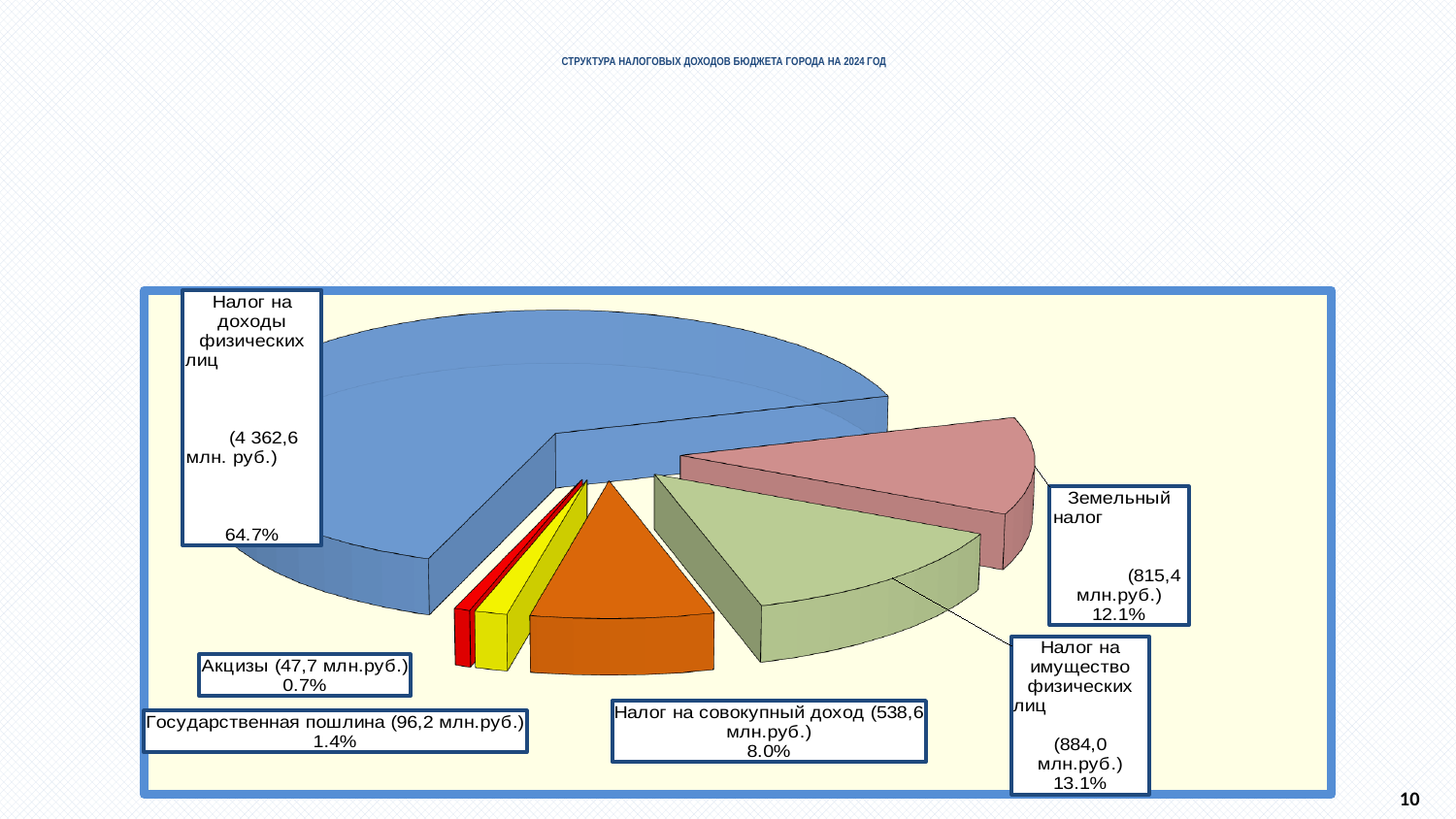
What is the value shown for "Акцизы"? 47,7 млн.руб. Which is larger: the share for "Земельный налог" or the share for "Налог на имущество физических лиц"? Налог на имущество физических лиц What share of the pie does "Налог на доходы физических лиц" represent? 64.7% What is the value shown for "Налог на имущество физических лиц"? 884,0 млн.руб. How many slices does the pie chart have? 6 What is the difference in percentage points between the shares of "Налог на имущество физических лиц" and "Земельный налог"? 1.0 Which category has the largest share of the pie? Налог на доходы физических лиц Which category has the smallest share of the pie? Акцизы What is the value shown for "Земельный налог"? 815,4 млн.руб. What is the title of the chart? СТРУКТУРА НАЛОГОВЫХ ДОХОДОВ БЮДЖЕТА ГОРОДА НА 2024 ГОД What percentage is shown for "Налог на совокупный доход"? 8.0% What kind of chart is shown on the slide? pie chart